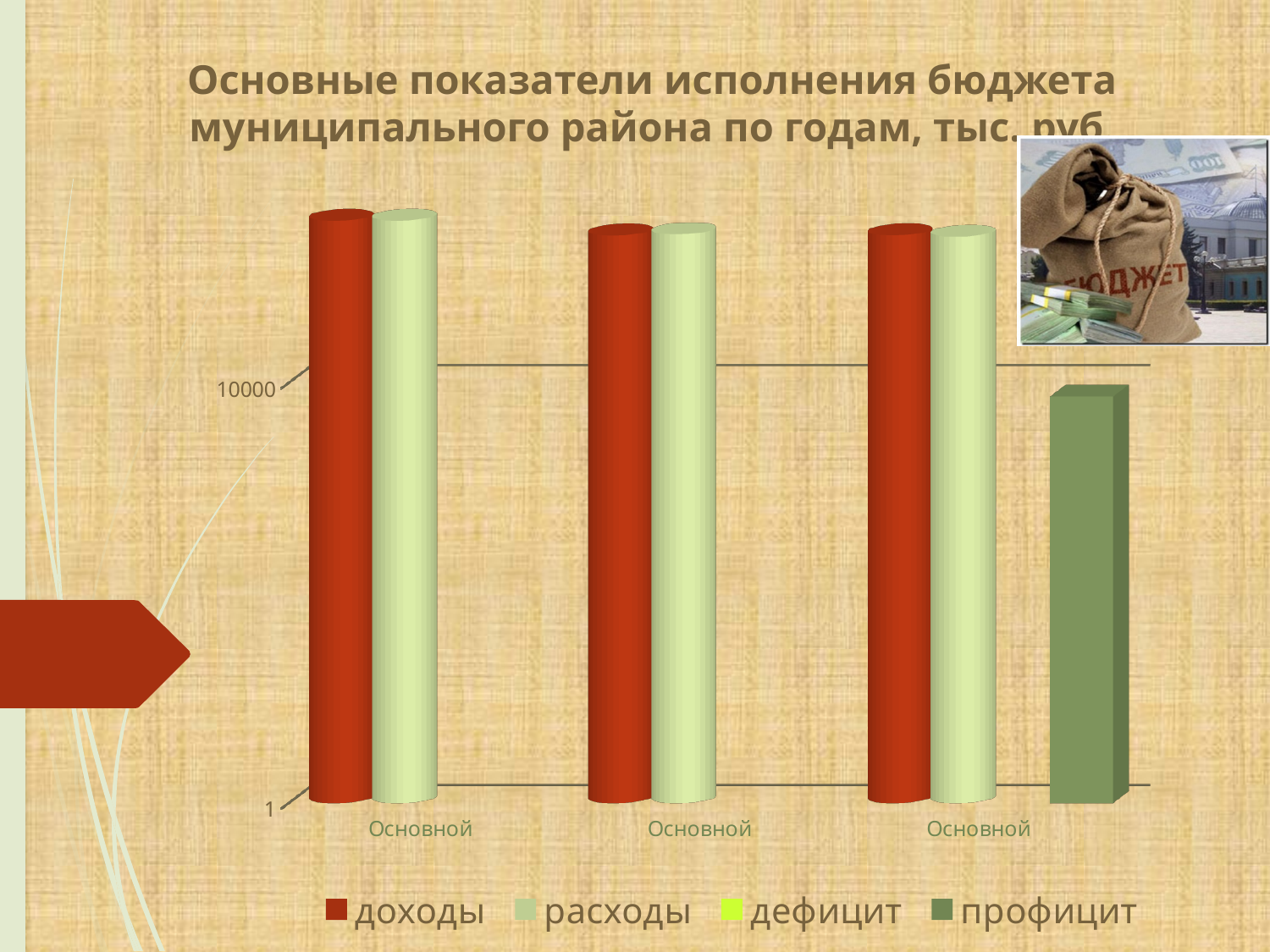
In which category group does a профицит bar appear? the third What kind of chart is shown on the slide? bar chart Is the value of профицит in the third category group greater or less than 10000? less How many series does the chart legend list? 4 Is the value of доходы in the first category group greater or less than 10000? greater How many category groups are plotted along the x axis? 3 What is the title of the chart on the slide? Основные показатели исполнения бюджета муниципального района по годам, тыс. руб. Which series has the lowest bar in the third category group? профицит Is the value of расходы in the second category group greater or less than 10000? greater In the third category group, which is larger: доходы or профицит? доходы Which series is shown in red in the legend? доходы